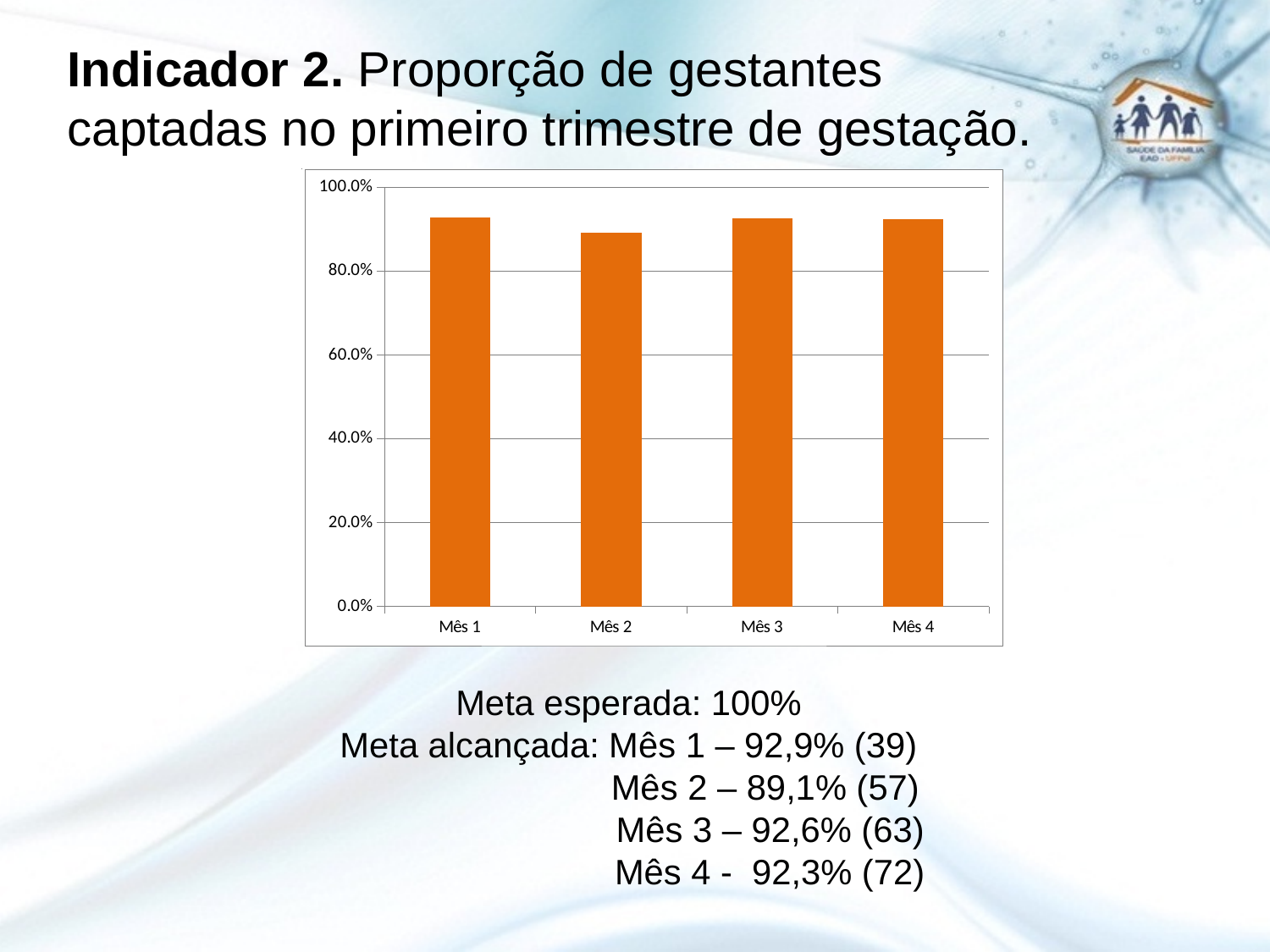
According to the slide, what proportion was reached in Mês 3? 92,6% How many months (categories) are plotted in the chart? 4 What is the expected target (meta esperada) stated on the slide? 100% Is the value for Mês 2 greater or less than 80.0%? greater What type of chart is shown on the slide? Bar chart Which month has the highest value according to the slide? Mês 1 According to the slide, what proportion was reached in Mês 4? 92,3% Which is larger, the value for Mês 1 or the value for Mês 2? Mês 1 What is the difference in percentage points between Mês 1 (92,9%) and Mês 2 (89,1%)? 3,8 According to the slide, what proportion was reached in Mês 1? 92,9% Which month has the lowest bar in the chart? Mês 2 According to the slide, what proportion was reached in Mês 2? 89,1%